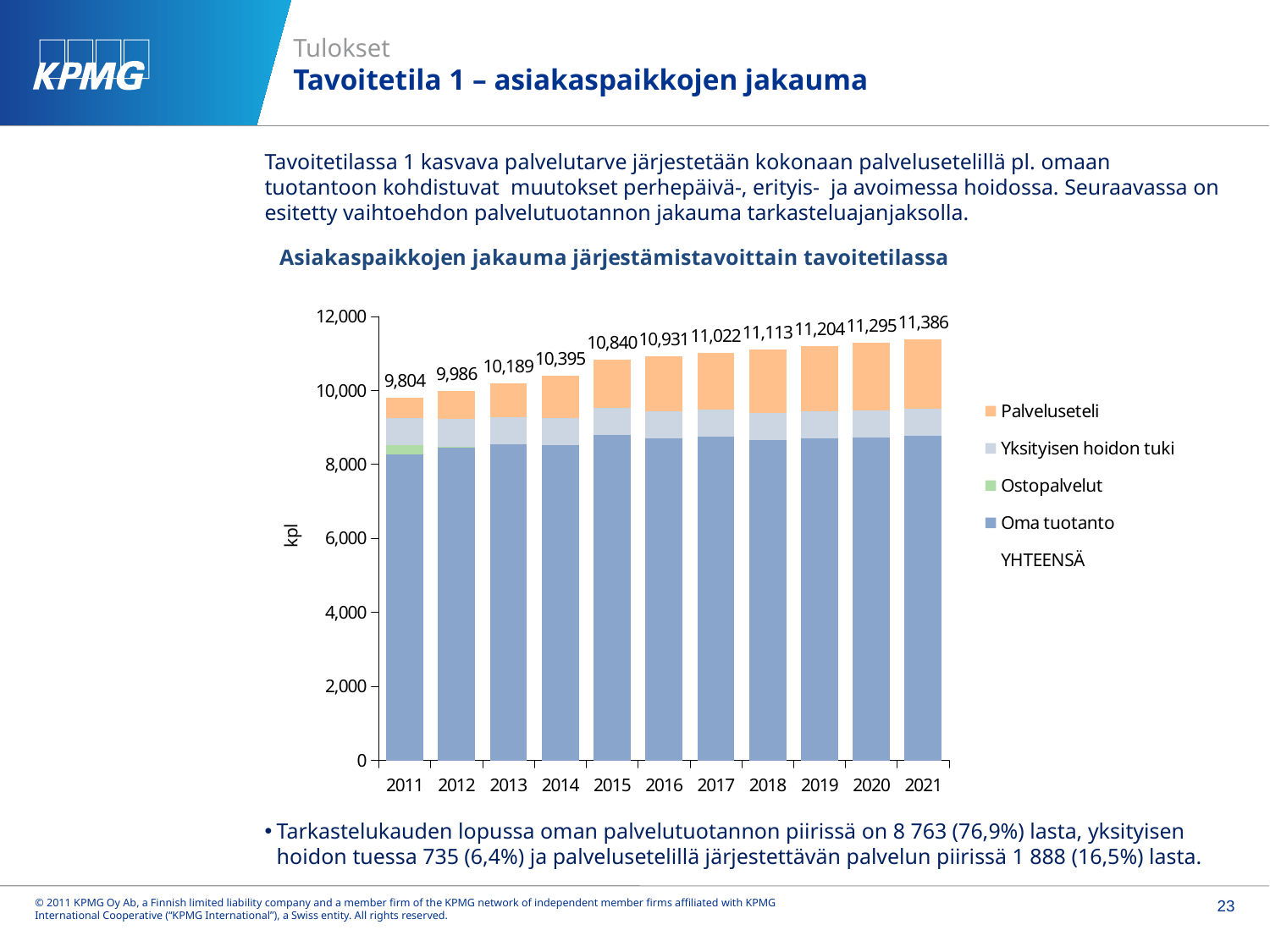
Which year has the highest total? 2021 What is the total value shown for 2011? 9,804 Which year has the lowest total? 2011 How many years are shown on the x axis? 11 What kind of chart is shown on the slide? Stacked bar chart Do the totals rise or fall from 2011 to 2021? Rise What is the total value shown for 2021? 11,386 Is the value for Oma tuotanto in 2011 greater or less than 8,000? greater How many entries does the legend list? 5 What is the total value shown for 2015? 10,840 Which is larger, the total for 2014 or the total for 2015? 2015 What is the difference between the totals for 2021 and 2011? 1,582